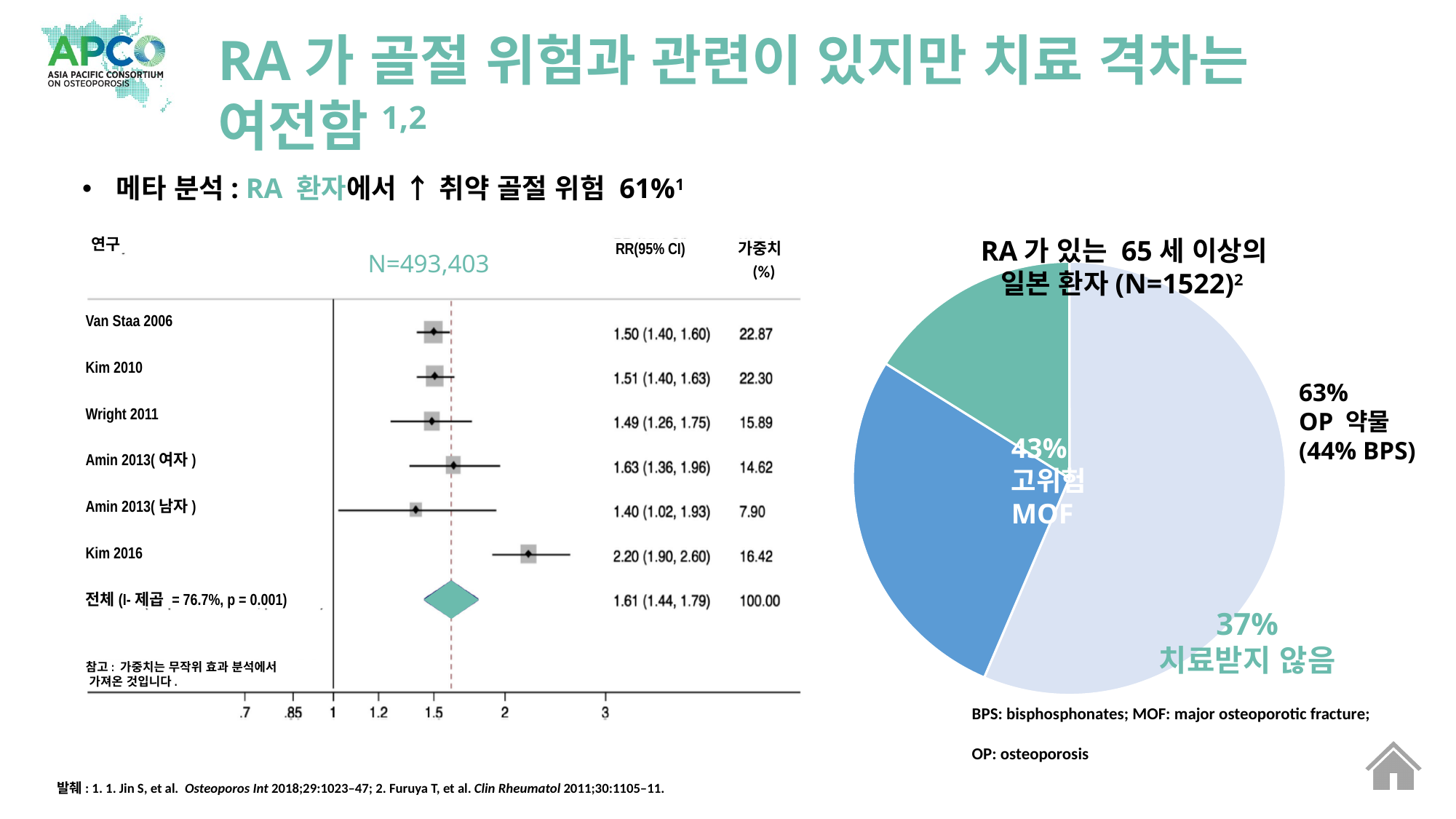
In the forest plot on the left, what is the weight (가중치 %) for Van Staa 2006? 22.87 In the forest plot on the left, which study has the highest RR point estimate? Kim 2016 In the pie chart on the right, what percentage of patients received OP 약물 (osteoporosis medication)? 63% In the forest plot on the left, what is the RR (95% CI) for Kim 2016? 2.20 (1.90, 2.60) In the forest plot on the left, what total N is shown above the plot? N=493,403 In the forest plot on the left, what is the overall (전체) pooled RR with its 95% CI? 1.61 (1.44, 1.79) What kind of chart is shown on the right side of the slide? Pie chart In the pie chart on the right, what percentage of patients are labelled 치료받지 않음 (untreated)? 37% In the forest plot on the left, which has a larger RR point estimate: Amin 2013( 여자 ) or Amin 2013( 남자 )? Amin 2013( 여자 ) In the forest plot on the left, what is the difference in weight between Van Staa 2006 (22.87) and Kim 2010 (22.30)? 0.57 In the forest plot on the left, which study has the lowest weight (가중치 %)? Amin 2013( 남자 ) In the forest plot on the left, how many individual studies (excluding the overall estimate) are listed? 6